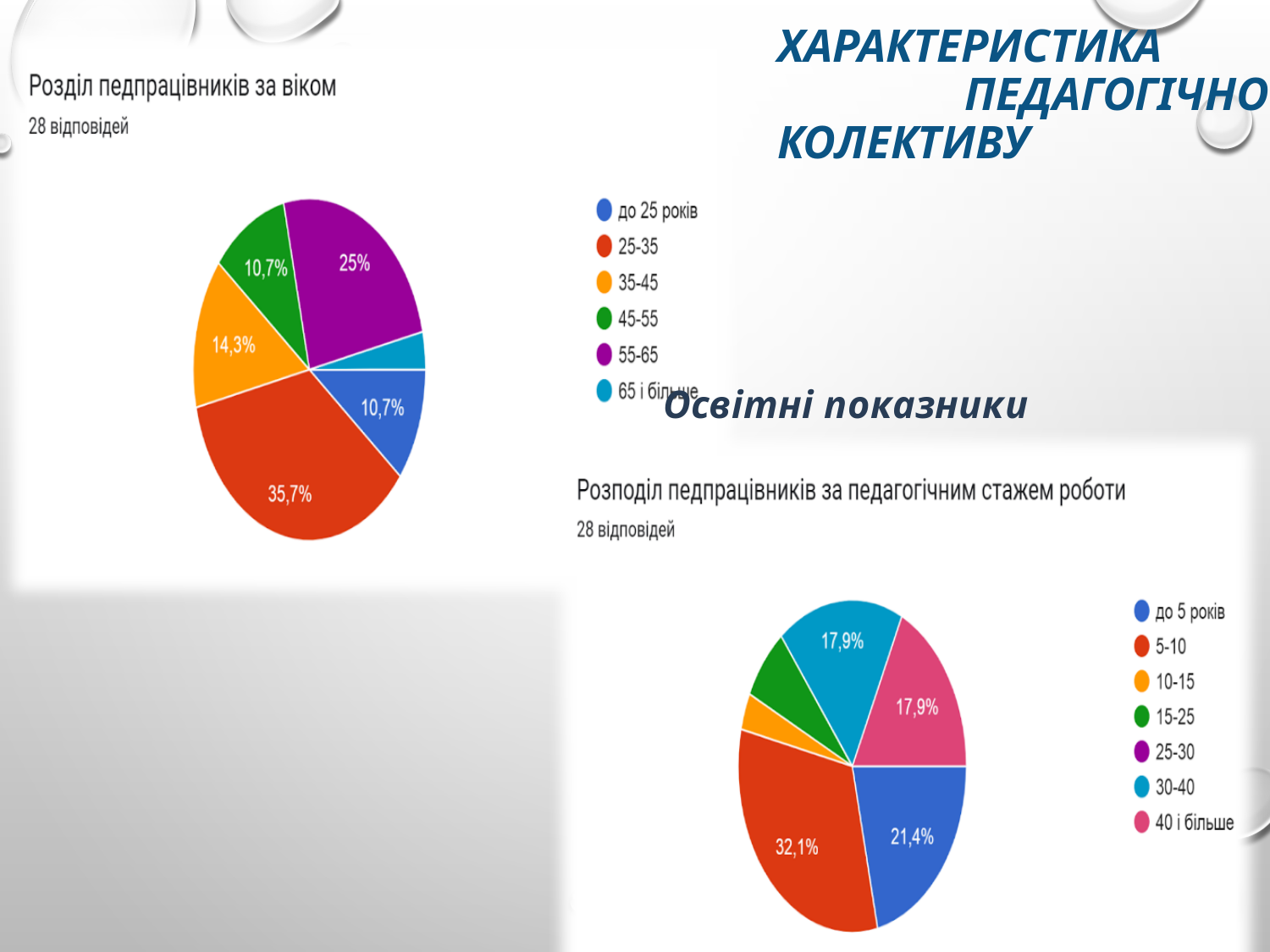
In the chart 'Розподіл педпрацівників за педагогічним стажем роботи', what share of respondents have up to 5 years of experience (до 5 років)? 21,4% In the chart 'Розділ педпрацівників за віком', which age group has the largest share? 25-35 In the chart 'Розділ педпрацівників за віком', what share of respondents are in the 25-35 age group? 35,7% What type of chart is 'Розподіл педпрацівників за педагогічним стажем роботи'? Pie chart In the chart 'Розподіл педпрацівників за педагогічним стажем роботи', which experience group has the largest share? 5-10 In the chart 'Розподіл педпрацівників за педагогічним стажем роботи', what share of respondents have 5-10 years of experience? 32,1% In the chart 'Розділ педпрацівників за віком', what is the difference between the shares of the 25-35 and 55-65 groups? 10,7% In the chart 'Розділ педпрацівників за віком', what share of respondents are in the 55-65 age group? 25% How many categories does the legend of the chart 'Розділ педпрацівників за віком' list? 6 In the chart 'Розділ педпрацівників за віком', which age group has the smallest share? 65 і більше In the chart 'Розподіл педпрацівників за педагогічним стажем роботи', which is larger: the share for 'до 5 років' or the share for '30-40'? до 5 років In the chart 'Розділ педпрацівників за віком', what share of respondents are in the 35-45 age group? 14,3%